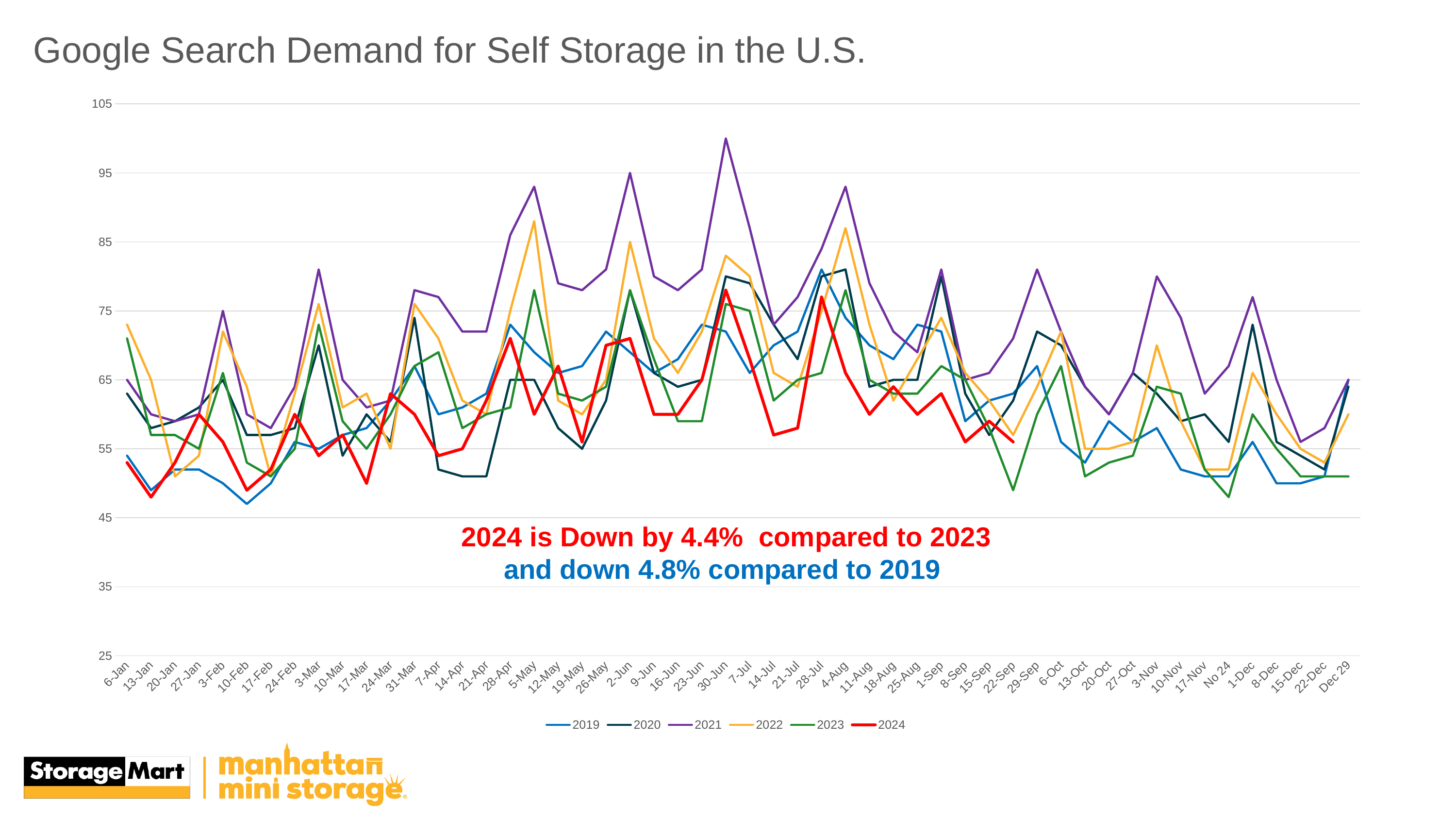
What kind of chart is shown on the slide? line chart Is the value for 2024 at 13-Jan greater or less than 55? less According to the annotation on the chart, by what percentage is 2024 down compared to 2023? 4.4% How many series does the legend list? 6 Which series reaches the highest value anywhere on the chart? 2021 Is the value for 2023 at 22-Sep greater or less than 55? less Is the value for 2021 at 30-Jun greater or less than 95? greater What is the title of the chart? Google Search Demand for Self Storage in the U.S. Does the 2021 line rise or fall between 30-Jun and 14-Jul? fall At 13-Jan, which series has the larger value, 2022 or 2024? 2022 Which series has the highest value at 30-Jun? 2021